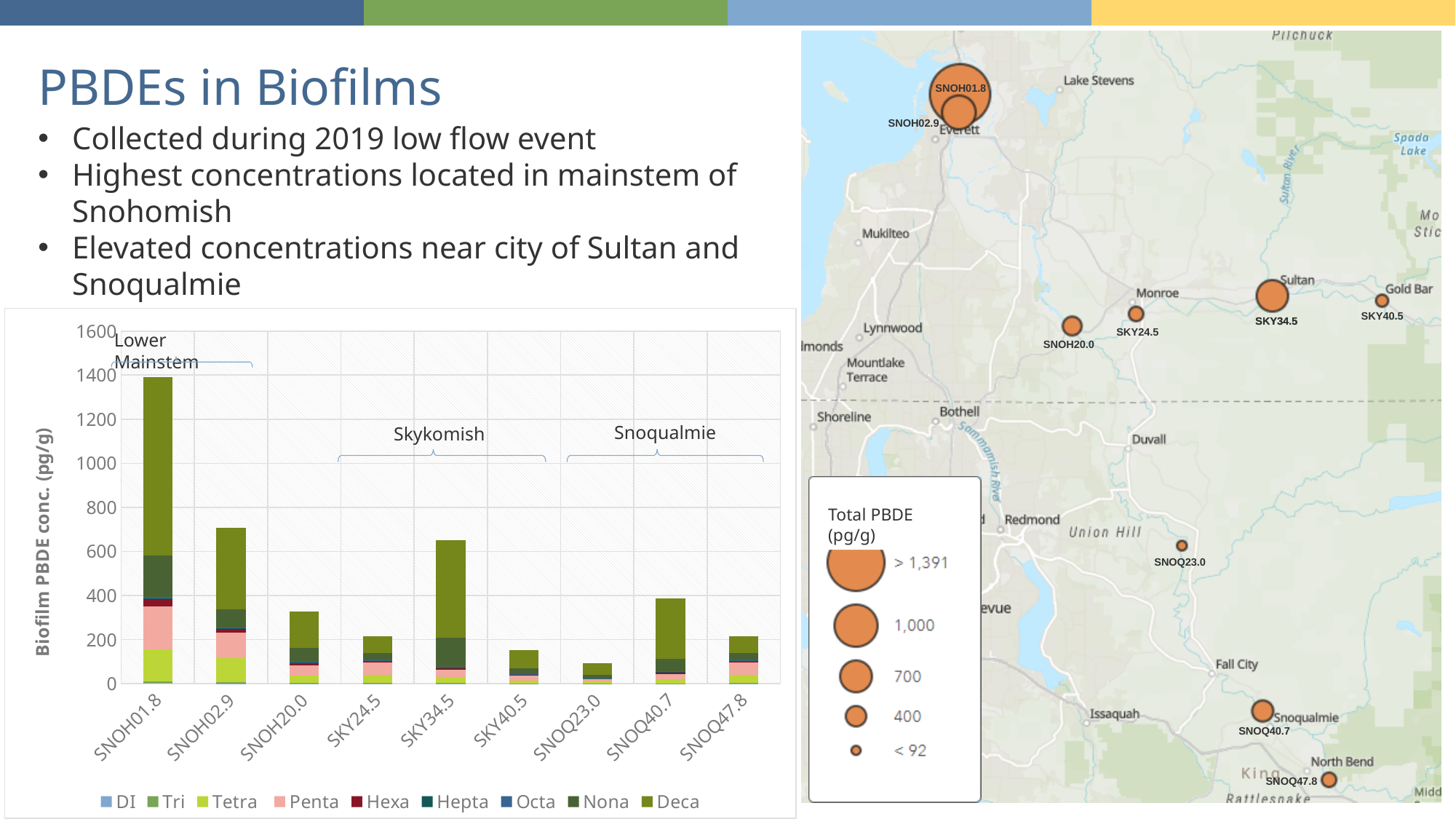
What kind of chart is shown on the left of the slide? Stacked bar chart How many sampling sites (categories) are shown on the x axis of the bar chart? 9 Is the total value for SNOH02.9 greater or less than 600? greater Which legend entry is listed last in the bar chart's legend? Deca Is the total value for SNOH01.8 greater or less than 1200? greater Which site has the highest total biofilm PBDE concentration in the bar chart? SNOH01.8 What is the title of the y axis of the bar chart? Biofilm PBDE conc. (pg/g) Is the total value for SKY40.5 greater or less than 200? less How many series does the legend of the bar chart list? 9 Which site has the lowest total biofilm PBDE concentration in the bar chart? SNOQ23.0 Which site has a larger total biofilm PBDE concentration, SKY34.5 or SNOQ40.7? SKY34.5